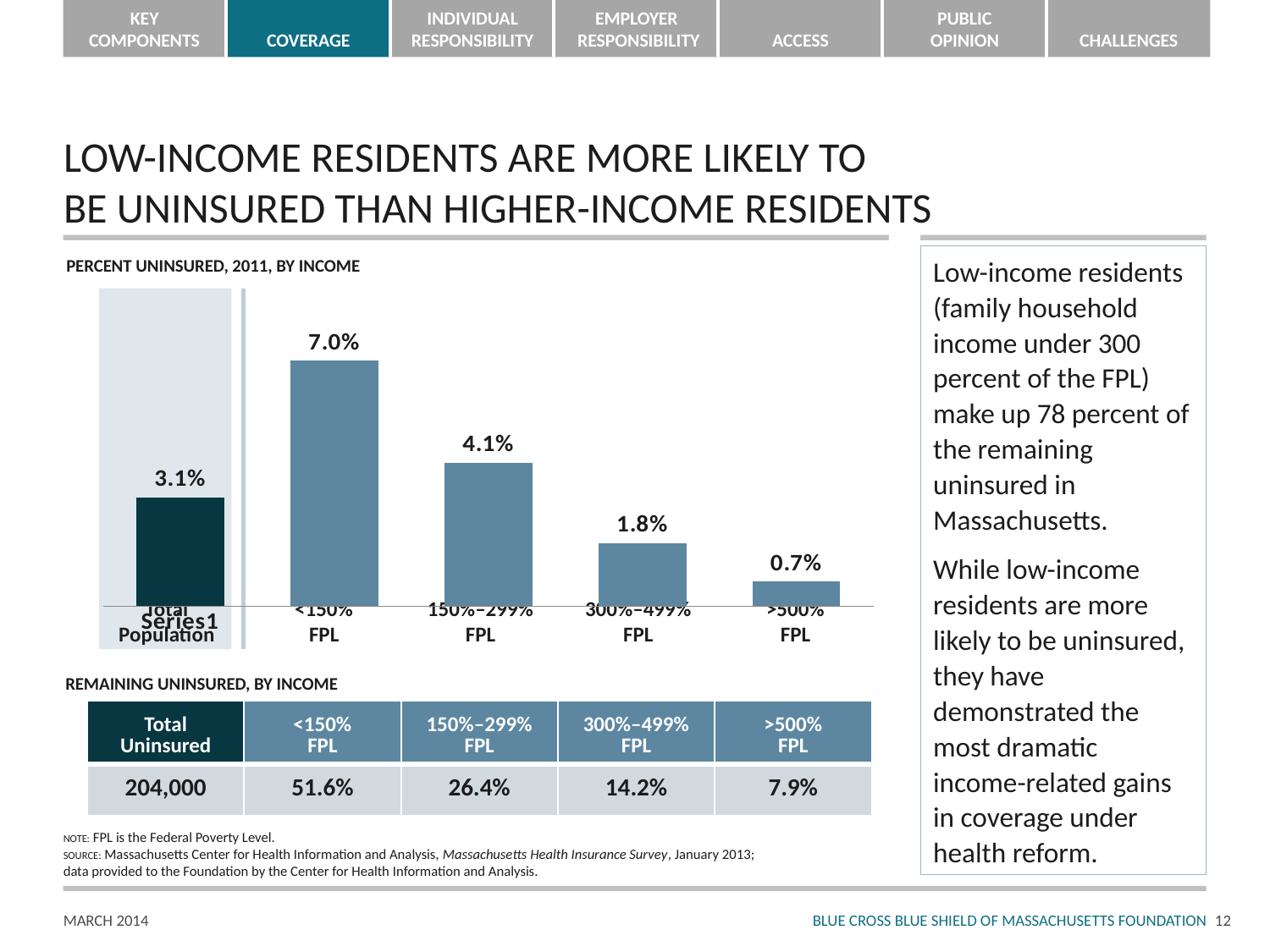
Which income group has the highest percent uninsured? <150% FPL What is the percent uninsured for the >500% FPL group? 0.7% What is the percent uninsured for residents with income under 150% FPL? 7.0% Which income group has the lowest percent uninsured? >500% FPL What is the percent uninsured for the 150%–299% FPL group? 4.1% What is the title of the chart? PERCENT UNINSURED, 2011, BY INCOME What is the difference in percent uninsured between the <150% FPL group and the 300%–499% FPL group? 5.2% What is the percent uninsured for the Total Population bar? 3.1% What type of chart is used to show percent uninsured by income? Bar chart Moving from the <150% FPL group to the >500% FPL group, do the percent uninsured values rise or fall? Fall How many bars are shown in the chart? 5 Which has a higher percent uninsured, the 150%–299% FPL group or the Total Population? 150%–299% FPL